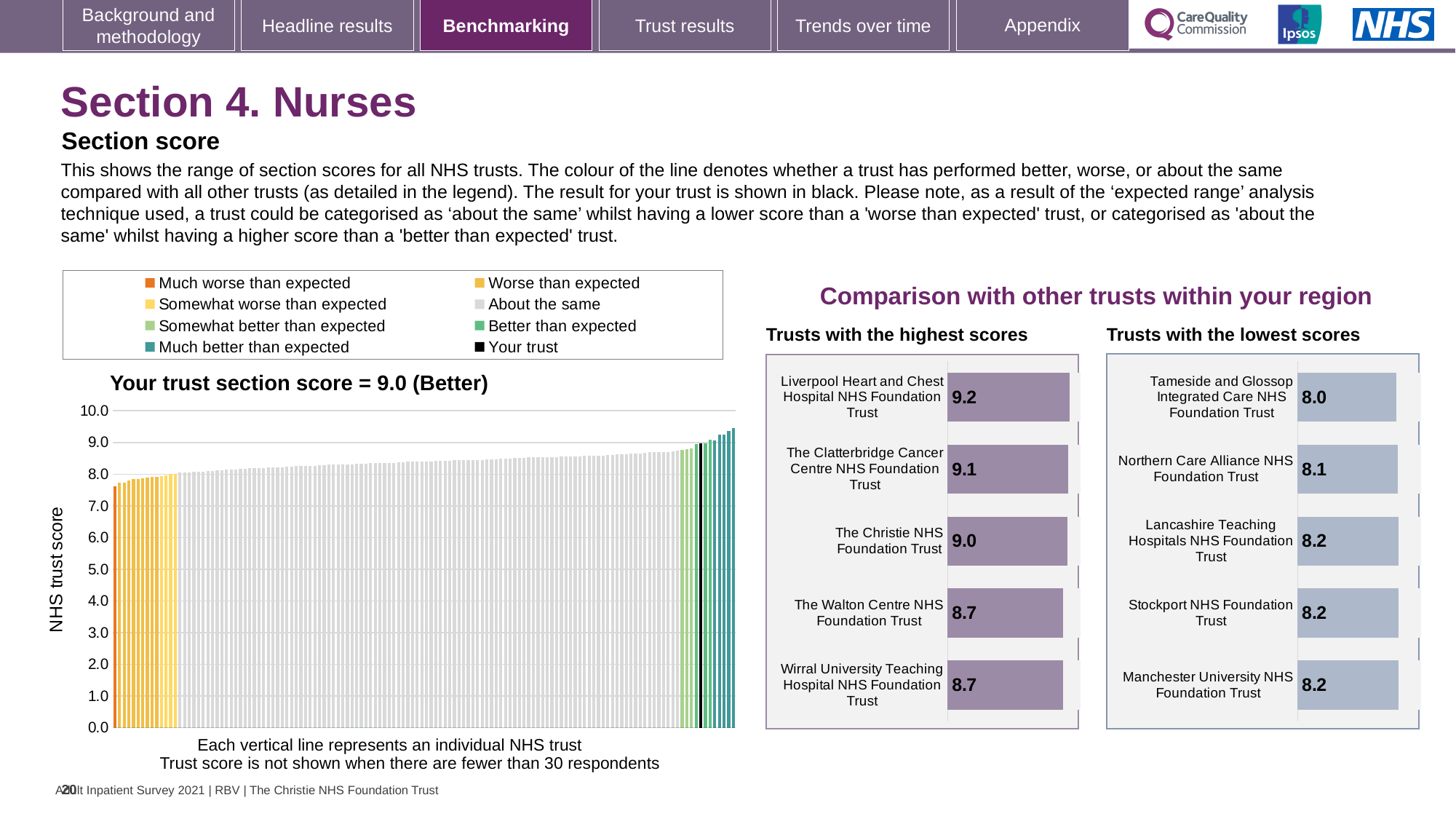
In the 'Trusts with the lowest scores' chart, what is the difference between the scores of Lancashire Teaching Hospitals NHS Foundation Trust and Tameside and Glossop Integrated Care NHS Foundation Trust? 0.2 What kind of chart is the 'Your trust section score' chart on the left of the slide? Bar chart In the 'Trusts with the lowest scores' chart, what is the score for Tameside and Glossop Integrated Care NHS Foundation Trust? 8.0 In the 'Trusts with the highest scores' chart, what is the score for Liverpool Heart and Chest Hospital NHS Foundation Trust? 9.2 In the 'Trusts with the highest scores' chart, what is the score for The Walton Centre NHS Foundation Trust? 8.7 In the 'Trusts with the highest scores' chart, which trust has the highest score? Liverpool Heart and Chest Hospital NHS Foundation Trust How many entries does the legend above the 'Your trust section score' chart list? 8 In the 'Trusts with the lowest scores' chart, which has the larger score: Northern Care Alliance NHS Foundation Trust or Tameside and Glossop Integrated Care NHS Foundation Trust? Northern Care Alliance NHS Foundation Trust How many trusts are shown in the 'Trusts with the highest scores' chart? 5 In the 'Trusts with the lowest scores' chart, which trust has the lowest score? Tameside and Glossop Integrated Care NHS Foundation Trust In the 'Trusts with the highest scores' chart, what is the difference between the scores of Liverpool Heart and Chest Hospital NHS Foundation Trust and The Walton Centre NHS Foundation Trust? 0.5 In the 'Your trust section score' chart on the left, do the bar values rise or fall from left to right? Rise